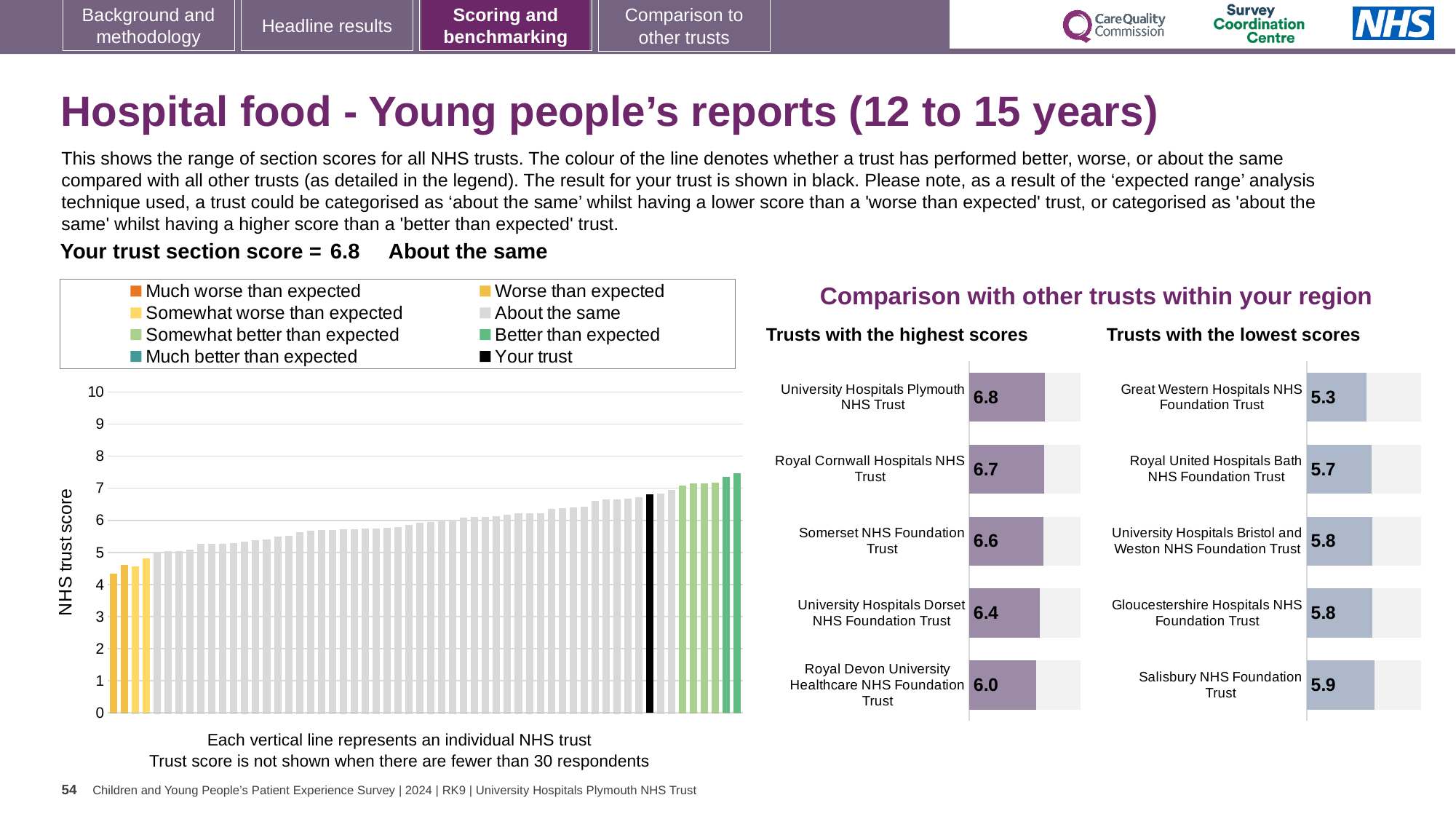
What kind of chart is the large chart on the left showing NHS trust scores? Bar chart In the 'Trusts with the lowest scores' chart, which has the higher score: Royal United Hospitals Bath NHS Foundation Trust or Salisbury NHS Foundation Trust? Salisbury NHS Foundation Trust In the 'Trusts with the highest scores' chart, how many trusts are listed? 5 In the 'Trusts with the highest scores' chart, what is the difference between the scores of University Hospitals Plymouth NHS Trust and Royal Devon University Healthcare NHS Foundation Trust? 0.8 How many entries does the legend above the large chart on the left list? 8 In the 'Trusts with the highest scores' chart, which trust has the highest score? University Hospitals Plymouth NHS Trust In the 'Trusts with the lowest scores' chart, which trust has the lowest score? Great Western Hospitals NHS Foundation Trust In the large chart on the left, do the bar values rise or fall from left to right? Rise In the large chart on the left, what is the section score for your trust (the black bar)? 6.8 In the 'Trusts with the lowest scores' chart, what is the difference between the scores of Salisbury NHS Foundation Trust and Great Western Hospitals NHS Foundation Trust? 0.6 In the 'Trusts with the lowest scores' chart, what is the score for Great Western Hospitals NHS Foundation Trust? 5.3 In the 'Trusts with the highest scores' chart, what is the score for Somerset NHS Foundation Trust? 6.6